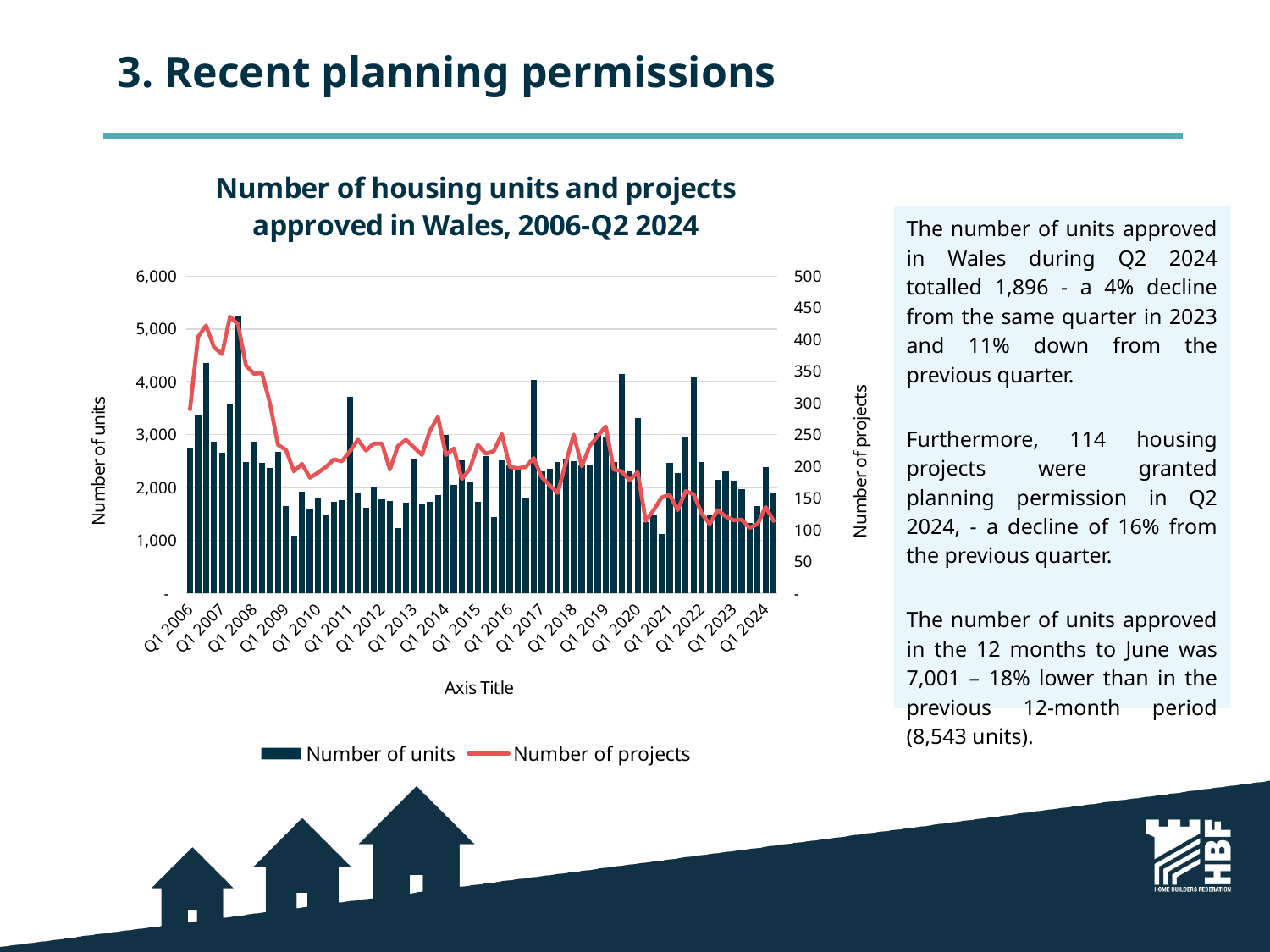
Is the number of units for Q1 2024 greater or less than 3,000? less Is the peak of the Number of projects line greater or less than 400? greater Does the Number of projects line rise or fall between Q1 2008 and Q1 2010? Fall Which has the larger number of units, Q1 2006 or Q1 2013? Q1 2006 What is the highest value shown on the left-hand axis (Number of units)? 6,000 What kind of chart is used to show the number of units? Bar chart How many series does the legend list? 2 Which series is drawn as a red line? Number of projects Is the number of units for Q1 2013 greater or less than 2,000? greater What is the title of the chart? Number of housing units and projects approved in Wales, 2006-Q2 2024 What is the highest value shown on the right-hand axis (Number of projects)? 500